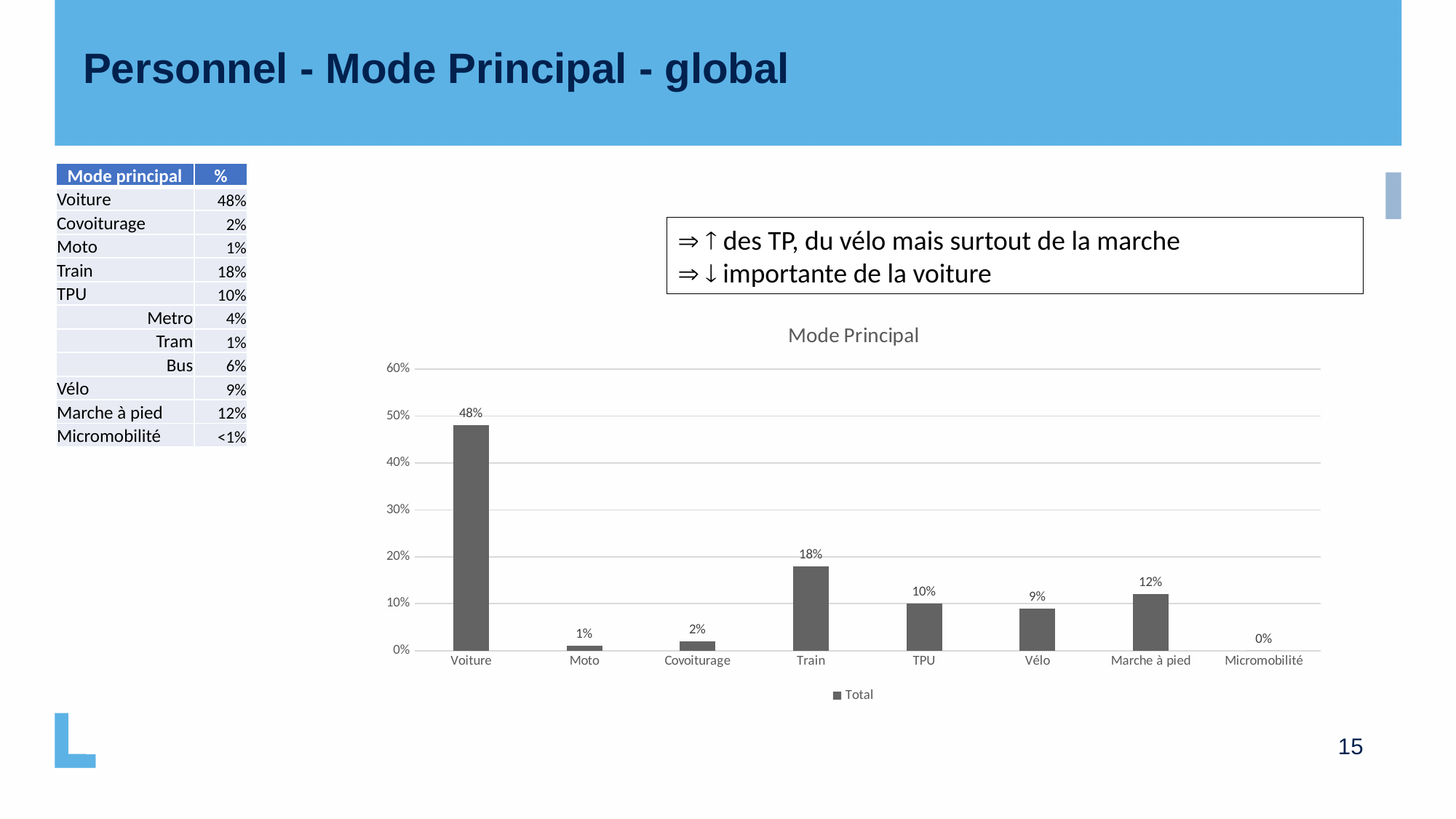
Which category has the highest value in the Mode Principal chart? Voiture What is the value for Train in the Mode Principal chart? 18% Which category has the lowest value in the Mode Principal chart? Micromobilité What is the value for Micromobilité in the Mode Principal chart? 0% How many categories are shown on the x axis of the Mode Principal chart? 8 Which is larger in the Mode Principal chart, TPU or Vélo? TPU How many series does the legend of the Mode Principal chart list? 1 Is the value for Voiture in the Mode Principal chart greater or less than 40%? greater What is the value for Voiture in the Mode Principal chart? 48% What kind of chart is the Mode Principal chart? Bar chart What is the value for Marche à pied in the Mode Principal chart? 12% What is the difference between the values for Voiture and Train in the Mode Principal chart? 30%